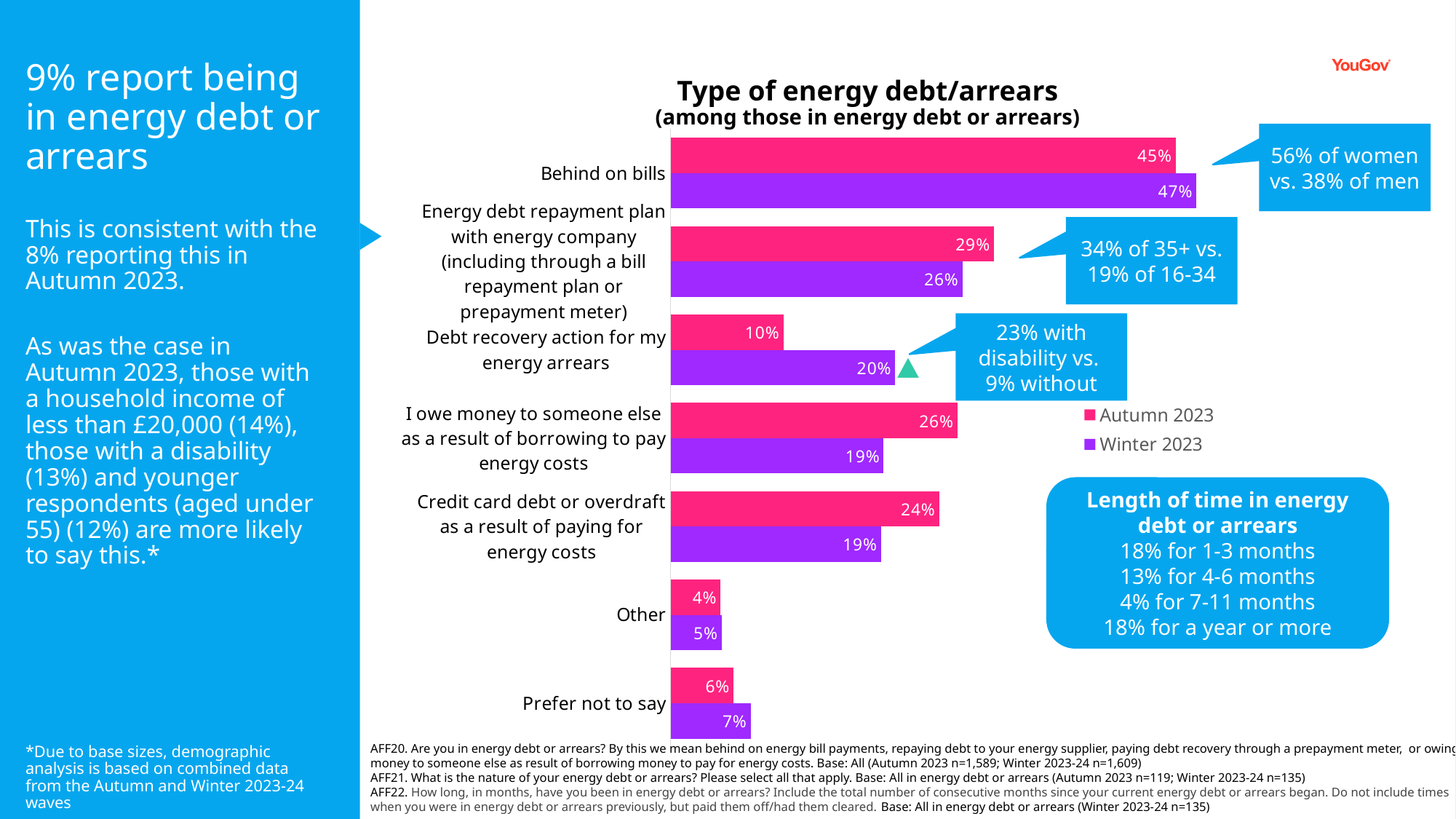
Which colour represents the Winter 2023 series? Purple What is the title of the chart? Type of energy debt/arrears (among those in energy debt or arrears) What kind of chart is shown on the slide? Bar chart How many series does the legend list? 2 Which is larger for 'I owe money to someone else as a result of borrowing to pay energy costs': the Autumn 2023 value or the Winter 2023 value? Autumn 2023 What is the Autumn 2023 value for 'Debt recovery action for my energy arrears'? 10% Which category has the highest Winter 2023 value? Behind on bills What is the Winter 2023 value for 'Credit card debt or overdraft as a result of paying for energy costs'? 19% How many categories are shown on the chart? 7 What is the difference between the Winter 2023 and Autumn 2023 values for 'Debt recovery action for my energy arrears'? 10 percentage points Which category has the lowest Autumn 2023 value? Other What is the Winter 2023 value for 'Behind on bills'? 47%